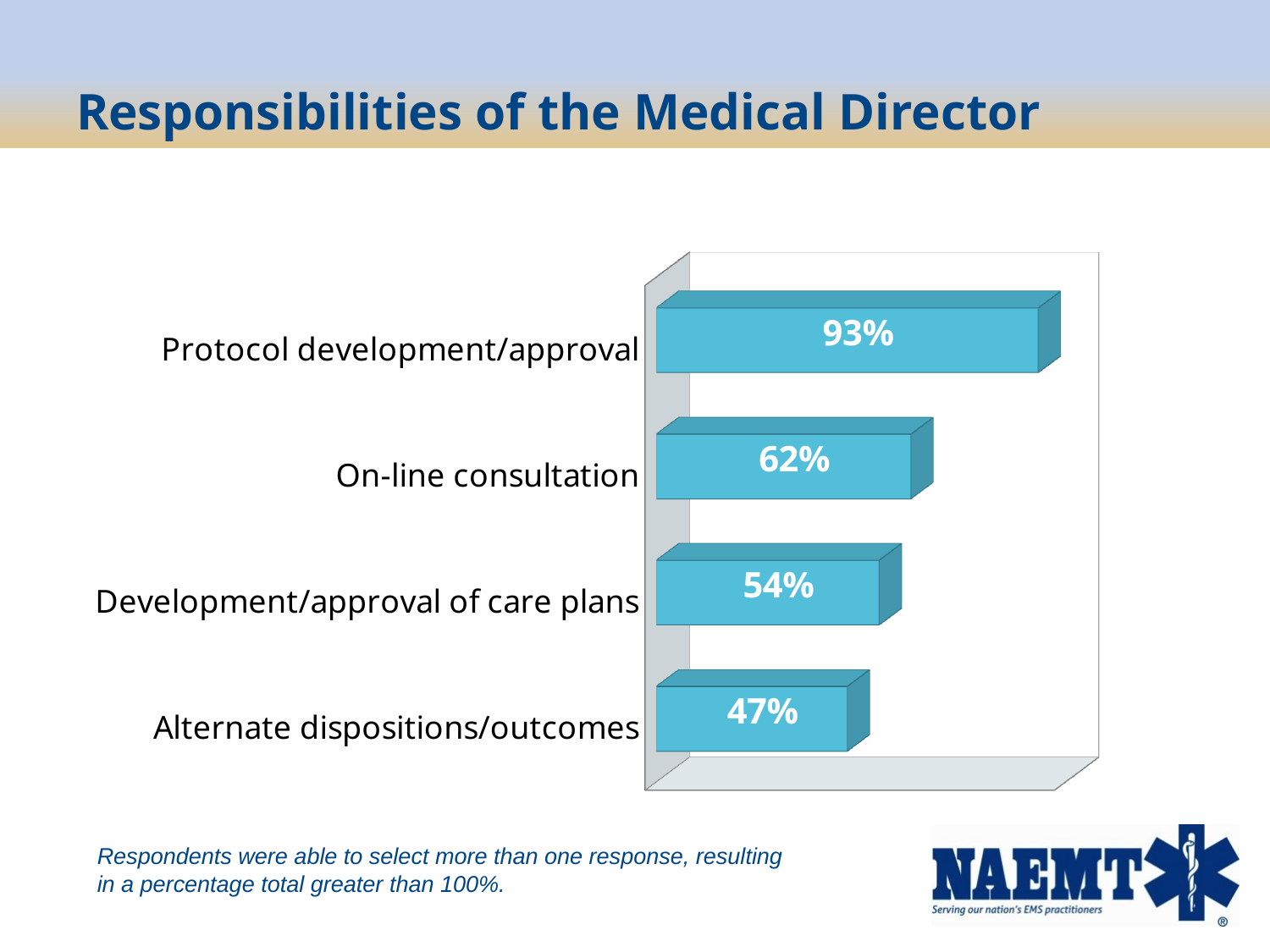
Which responsibility has the lowest percentage? Alternate dispositions/outcomes What percentage is shown for On-line consultation? 62% What is the title of the slide containing the chart? Responsibilities of the Medical Director What percentage is shown for Alternate dispositions/outcomes? 47% What percentage is shown for Protocol development/approval? 93% How many responsibilities are shown in the chart? 4 What is the difference in percentage points between Development/approval of care plans and Alternate dispositions/outcomes? 7 What is the difference in percentage points between Protocol development/approval and On-line consultation? 31 Which responsibility has the highest percentage? Protocol development/approval Which has a higher percentage, On-line consultation or Development/approval of care plans? On-line consultation What percentage is shown for Development/approval of care plans? 54% What kind of chart is shown on the slide? Bar chart